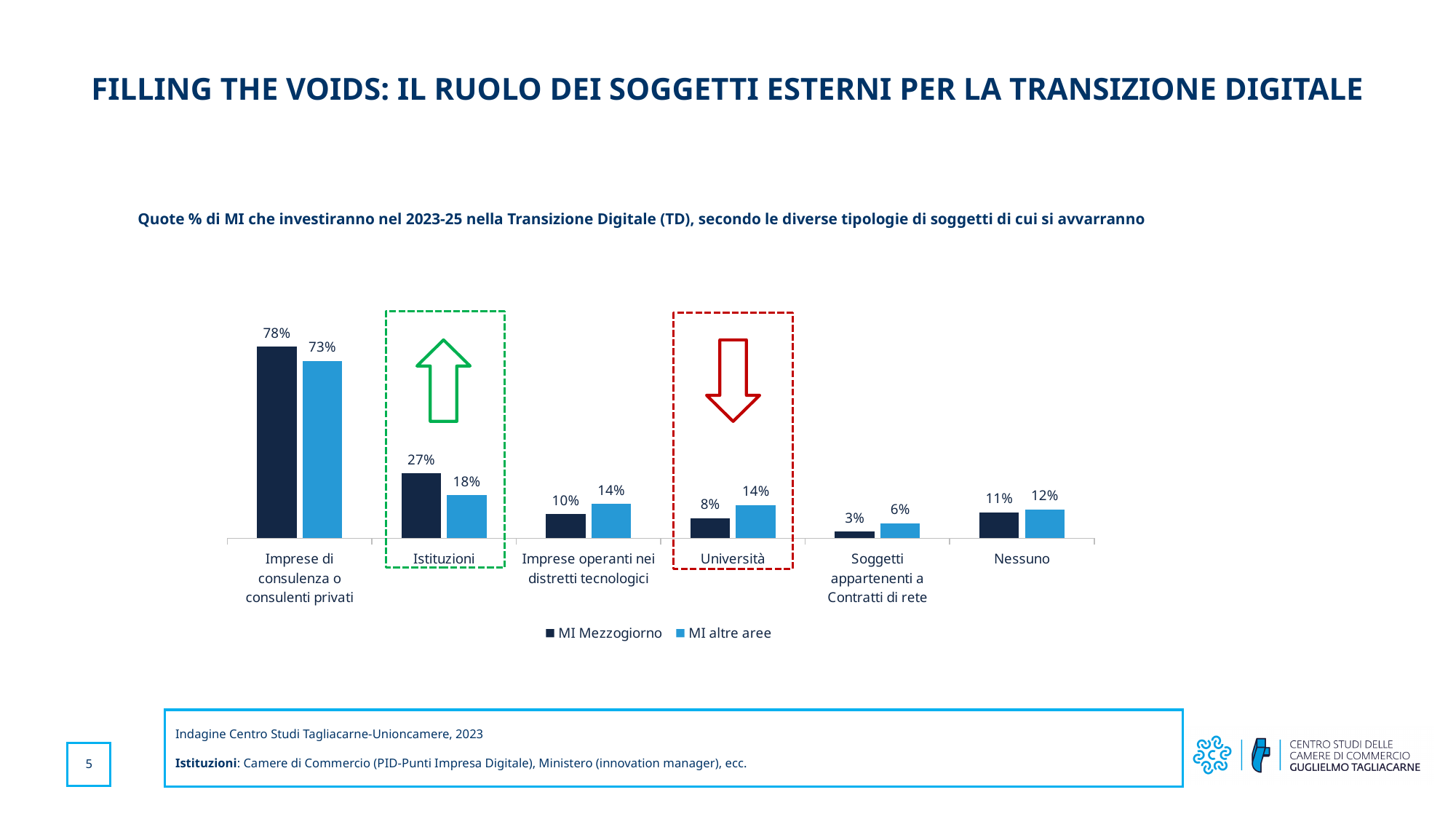
What is the value for MI Mezzogiorno in the 'Università' category? 8% How many categories are shown on the x axis of the chart? 6 What is the difference between MI Mezzogiorno and MI altre aree in the 'Istituzioni' category? 9% Which category is highlighted with a green dashed box and an upward arrow? Istituzioni What is the value for MI altre aree in the 'Istituzioni' category? 18% What is the difference between MI altre aree and MI Mezzogiorno in the 'Università' category? 6% What is the value for MI Mezzogiorno in the 'Imprese di consulenza o consulenti privati' category? 78% Which category has the lowest value for MI Mezzogiorno? Soggetti appartenenti a Contratti di rete Which category has the highest value for MI altre aree? Imprese di consulenza o consulenti privati How many series does the legend list? 2 In the 'Imprese operanti nei distretti tecnologici' category, which series has the larger value, MI Mezzogiorno or MI altre aree? MI altre aree What kind of chart is shown on the slide? Bar chart